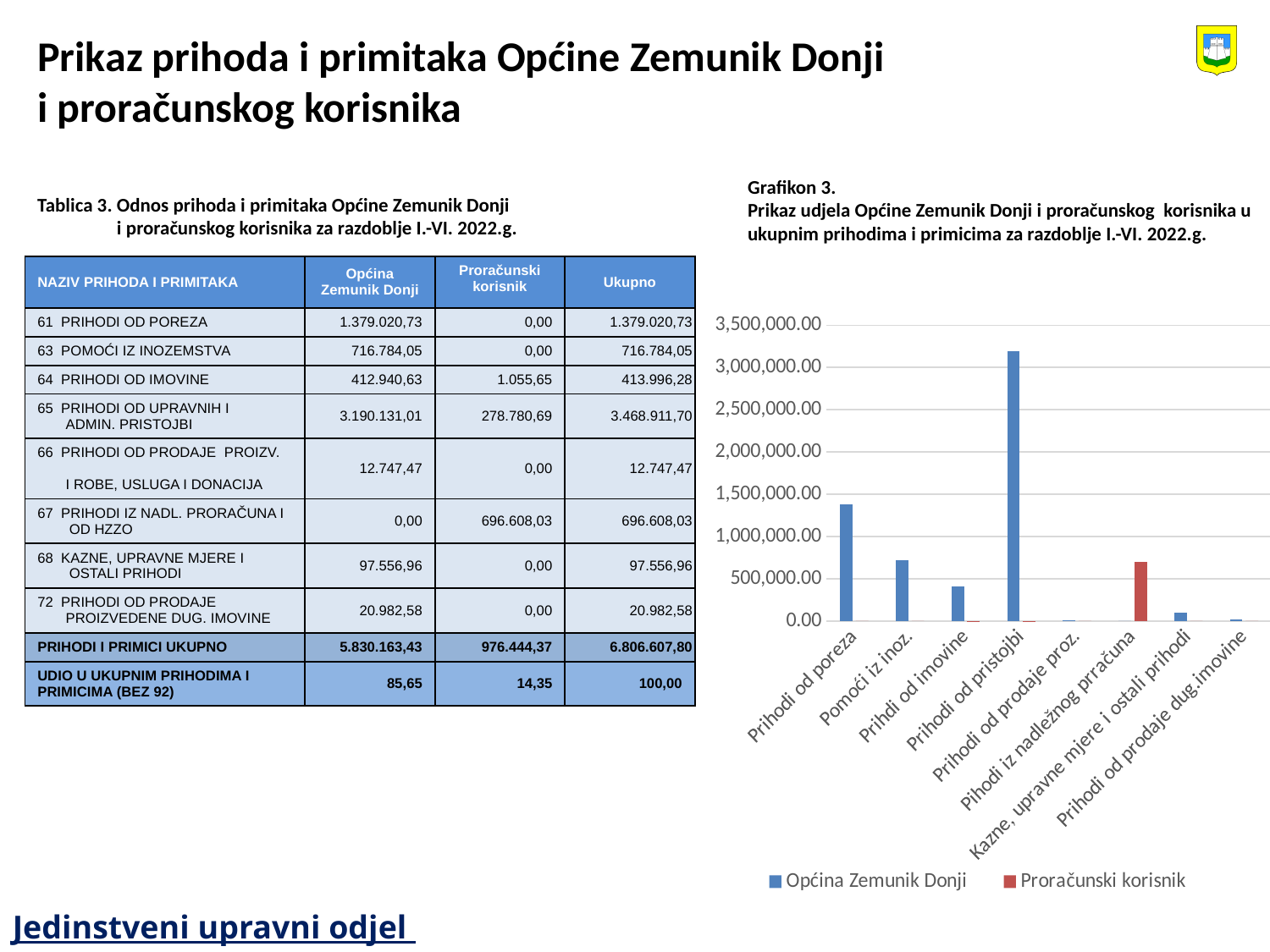
What kind of chart is Grafikon 3 on the slide? bar chart In Grafikon 3, what colour represents the Proračunski korisnik series? red In Grafikon 3, which category has the highest value for Proračunski korisnik? Pihodi iz nadležnog prračuna In Grafikon 3, is the Općina Zemunik Donji value for Pomoći iz inoz. greater or less than 500,000.00? greater In Grafikon 3, is the Općina Zemunik Donji value for Prihodi od imovine greater or less than 500,000.00? less How many categories are shown along the x axis of Grafikon 3? 8 How many series does the legend of Grafikon 3 list? 2 In Grafikon 3, which is larger for Općina Zemunik Donji: Prihodi od poreza or Pomoći iz inoz.? Prihodi od poreza In Grafikon 3, which is larger for Proračunski korisnik: Prihodi iz nadležnog prračuna or Prihodi od pristojbi? Prihodi iz nadležnog prračuna In Grafikon 3, is the Općina Zemunik Donji value for Prihodi od poreza greater or less than 1,500,000.00? less In Grafikon 3, which category has the highest value for Općina Zemunik Donji? Prihodi od pristojbi